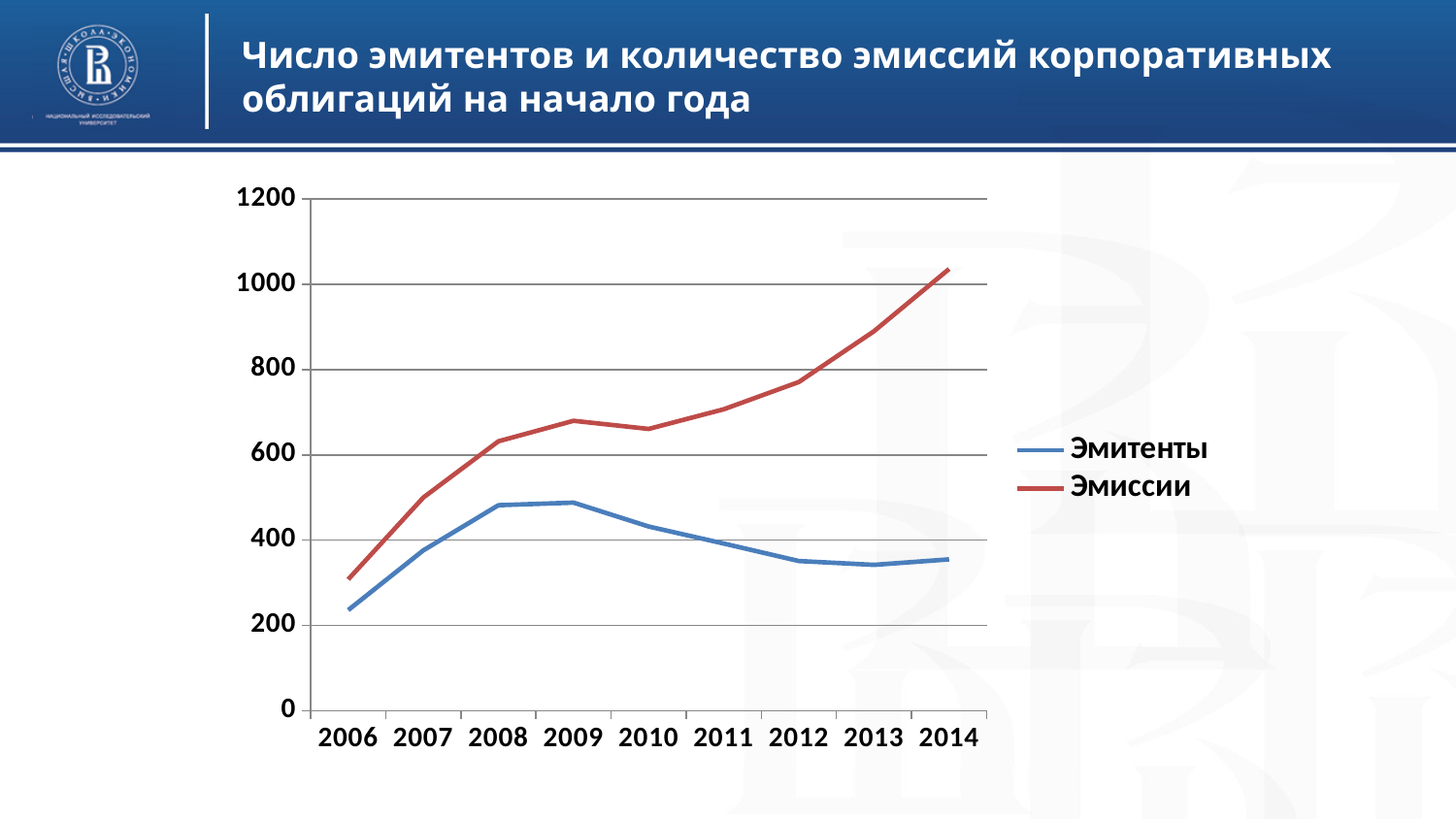
Is the value for Эмиссии in 2014 greater or less than 1000? greater What kind of chart is shown on the slide? line chart Which year has the lowest value for Эмитенты? 2006 In 2010, which series has the larger value, Эмитенты or Эмиссии? Эмиссии How many years are plotted along the x axis? 9 Is the value for Эмиссии in 2009 greater or less than 600? greater Which year has the lowest value for Эмиссии? 2006 Is the value for Эмитенты in 2012 greater or less than 400? less How many series does the legend list? 2 Does the Эмиссии line generally rise or fall from 2006 to 2014? rise What colour is the line for Эмиссии? red Which year has the highest value for Эмиссии? 2014